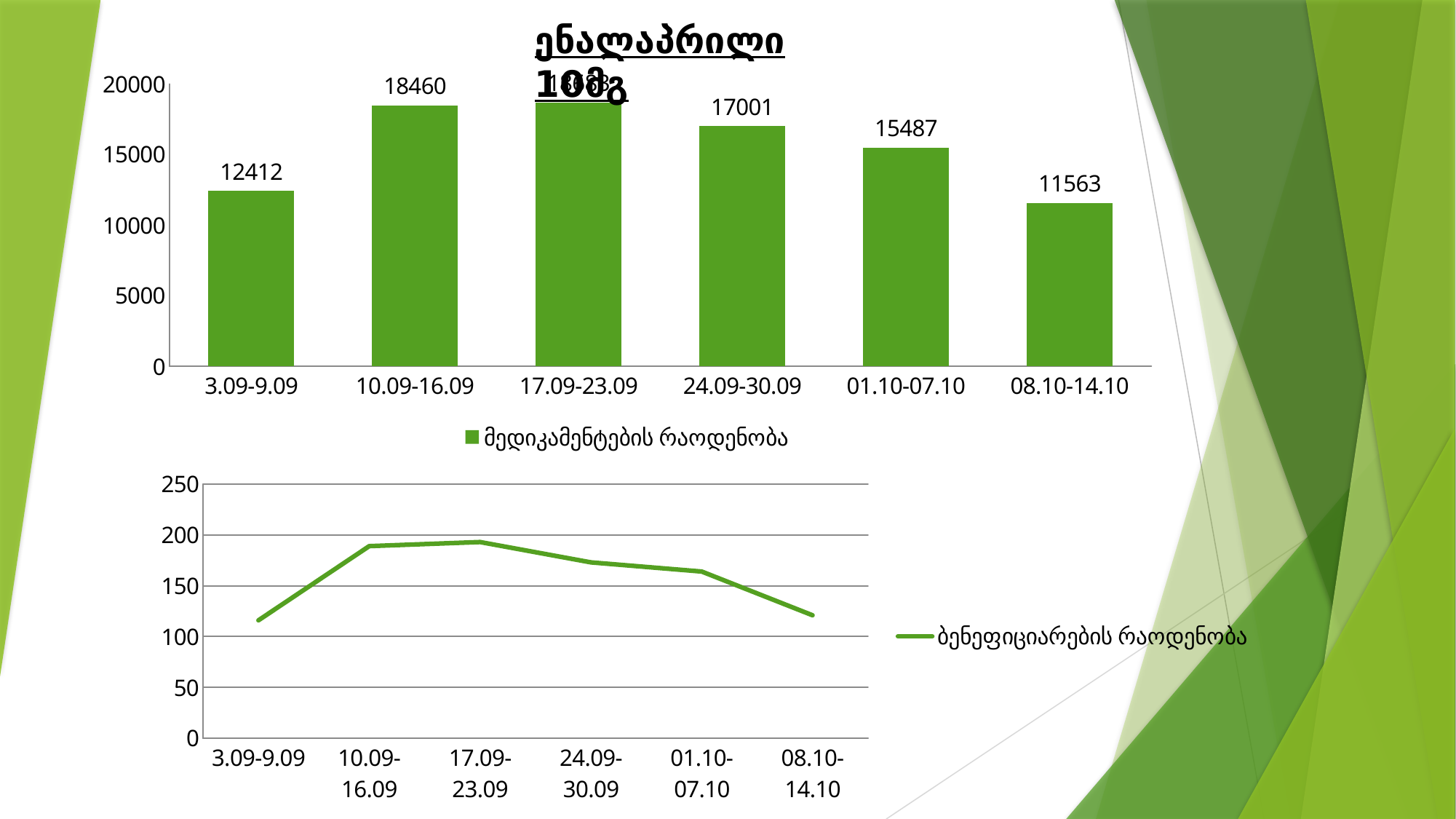
In the top bar chart, what is the value for 3.09-9.09? 12412 How many periods are shown on the x axis of the top bar chart? 6 In the bottom line chart, is the value for 10.09-16.09 greater or less than 150? greater In the top bar chart, which is larger: the value for 24.09-30.09 or the value for 08.10-14.10? 24.09-30.09 In the top bar chart, what is the value for 10.09-16.09? 18460 What kind of chart is the top chart on the slide? bar chart In the top bar chart, what is the value for 24.09-30.09? 17001 In the top bar chart, which period has the lowest value? 08.10-14.10 What kind of chart is the bottom chart on the slide? line chart In the top bar chart, what is the difference between the values for 10.09-16.09 and 24.09-30.09? 1459 In the top bar chart, what is the value for 01.10-07.10? 15487 In the bottom line chart, is the value for 3.09-9.09 greater or less than 150? less